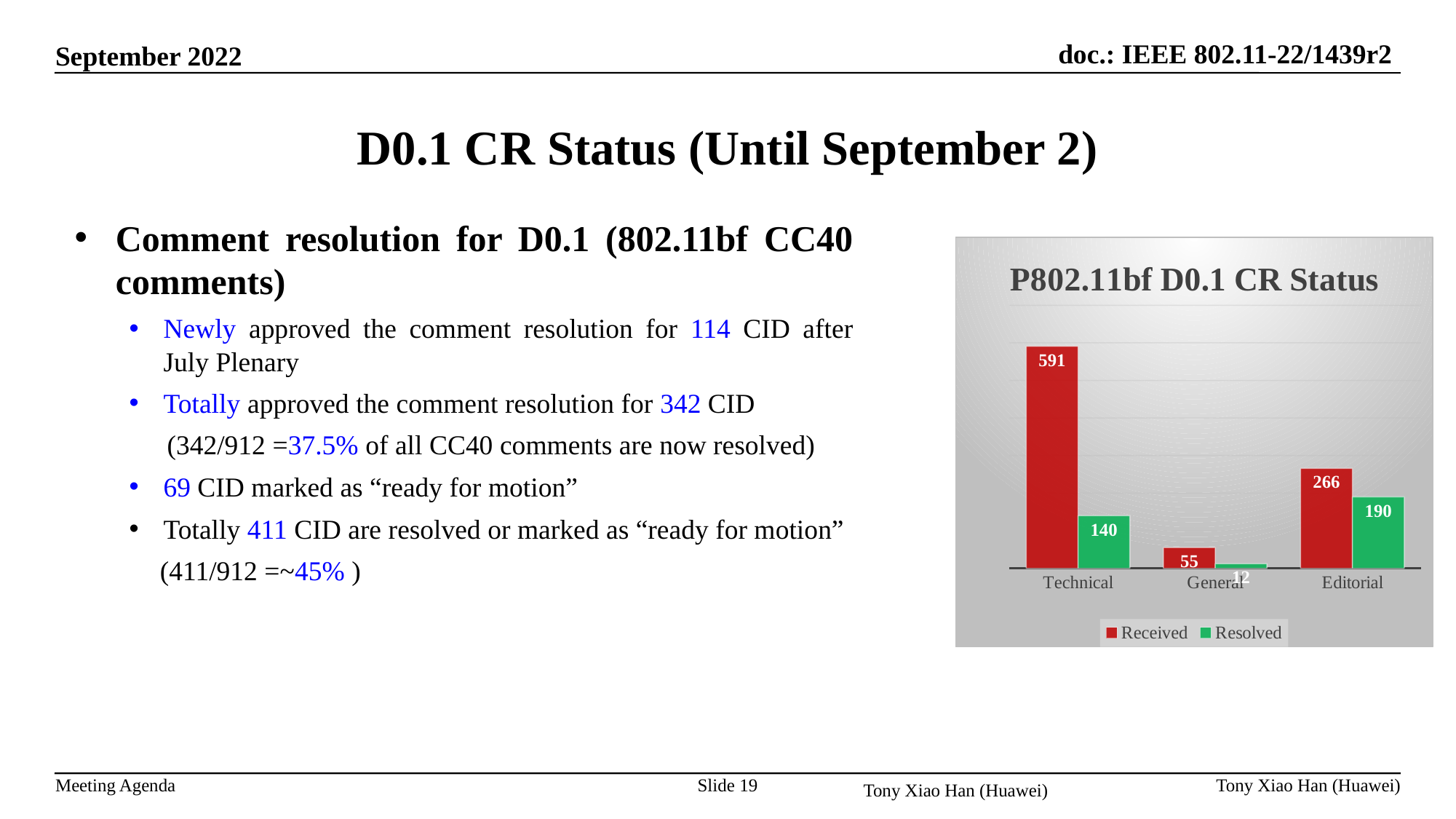
What is the difference between Received and Resolved for Technical? 451 What is the Received value for General? 55 How many series does the legend list? 2 Which category has the lowest Resolved value? General What is the Received value for Technical? 591 What is the Resolved value for Editorial? 190 What kind of chart is shown on the slide? Bar chart What is the difference between Received and Resolved for Editorial? 76 What is the Resolved value for Technical? 140 Which category has the highest Received value? Technical How many categories are shown on the x axis? 3 Which is larger, the Resolved value for Editorial or the Resolved value for Technical? Editorial